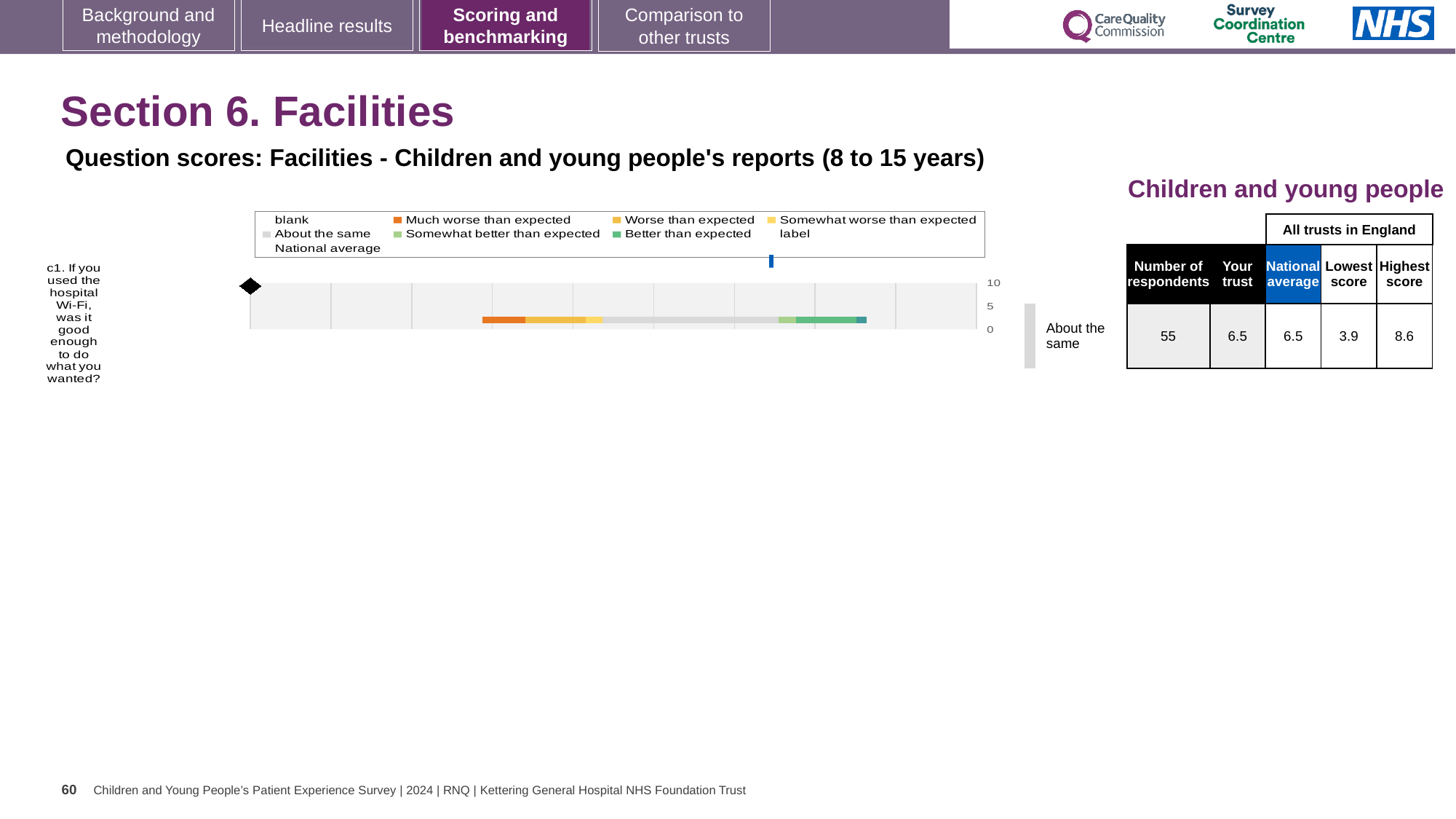
What colour does the legend use for 'Much worse than expected'? Orange How many respondents answered question c1 (hospital Wi-Fi)? 55 What is the 'Your trust' score for question c1 (hospital Wi-Fi)? 6.5 What is the highest score among all trusts in England for question c1? 8.6 What is the national average score for question c1 (hospital Wi-Fi)? 6.5 What is the lowest score among all trusts in England for question c1? 3.9 What kind of chart is used to show the expected ranges for question c1? Bar chart What is the difference between the highest score and the lowest score for question c1? 4.7 Which benchmark category is the trust's result for question c1 placed in? About the same Which question is shown on the chart? c1. If you used the hospital Wi-Fi, was it good enough to do what you wanted? How many survey questions are plotted in the chart? 1 Is the 'Your trust' score for question c1 higher or lower than the national average? They are the same (6.5)